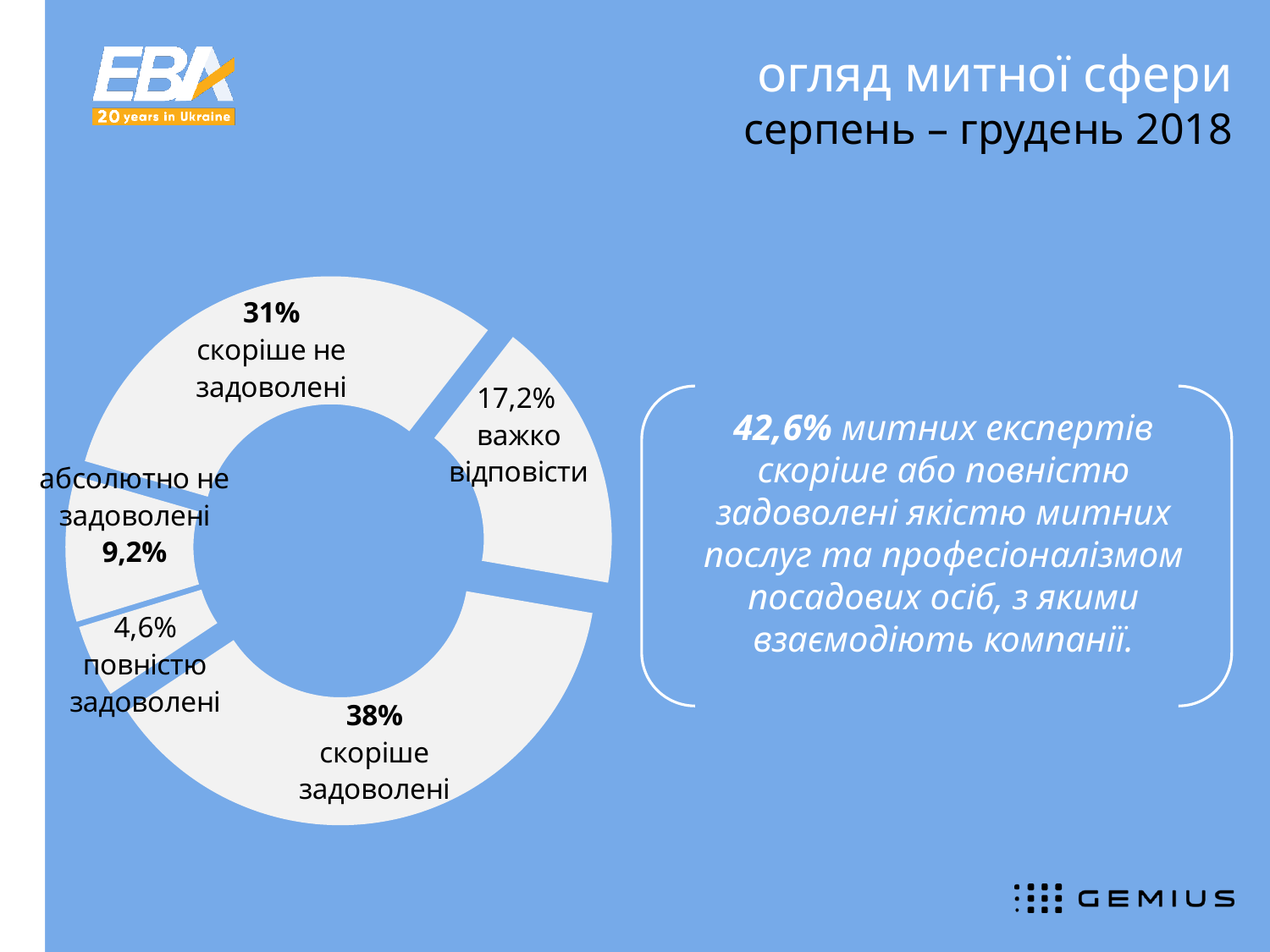
What share of respondents answered "абсолютно не задоволені"? 9,2% How many response categories are shown in the chart? 5 How many percentage points larger is the share for "абсолютно не задоволені" than for "повністю задоволені"? 4,6 What share of respondents answered "скоріше задоволені"? 38% What share of respondents answered "важко відповісти"? 17,2% What share of respondents answered "скоріше не задоволені"? 31% Which response category has the smallest share of the chart? повністю задоволені How many percentage points larger is the share for "скоріше задоволені" than for "скоріше не задоволені"? 7 Which response category has the largest share of the chart? скоріше задоволені Which is larger: the share for "важко відповісти" or the share for "абсолютно не задоволені"? важко відповісти What kind of chart is shown on the slide? doughnut chart What share of respondents answered "повністю задоволені"? 4,6%